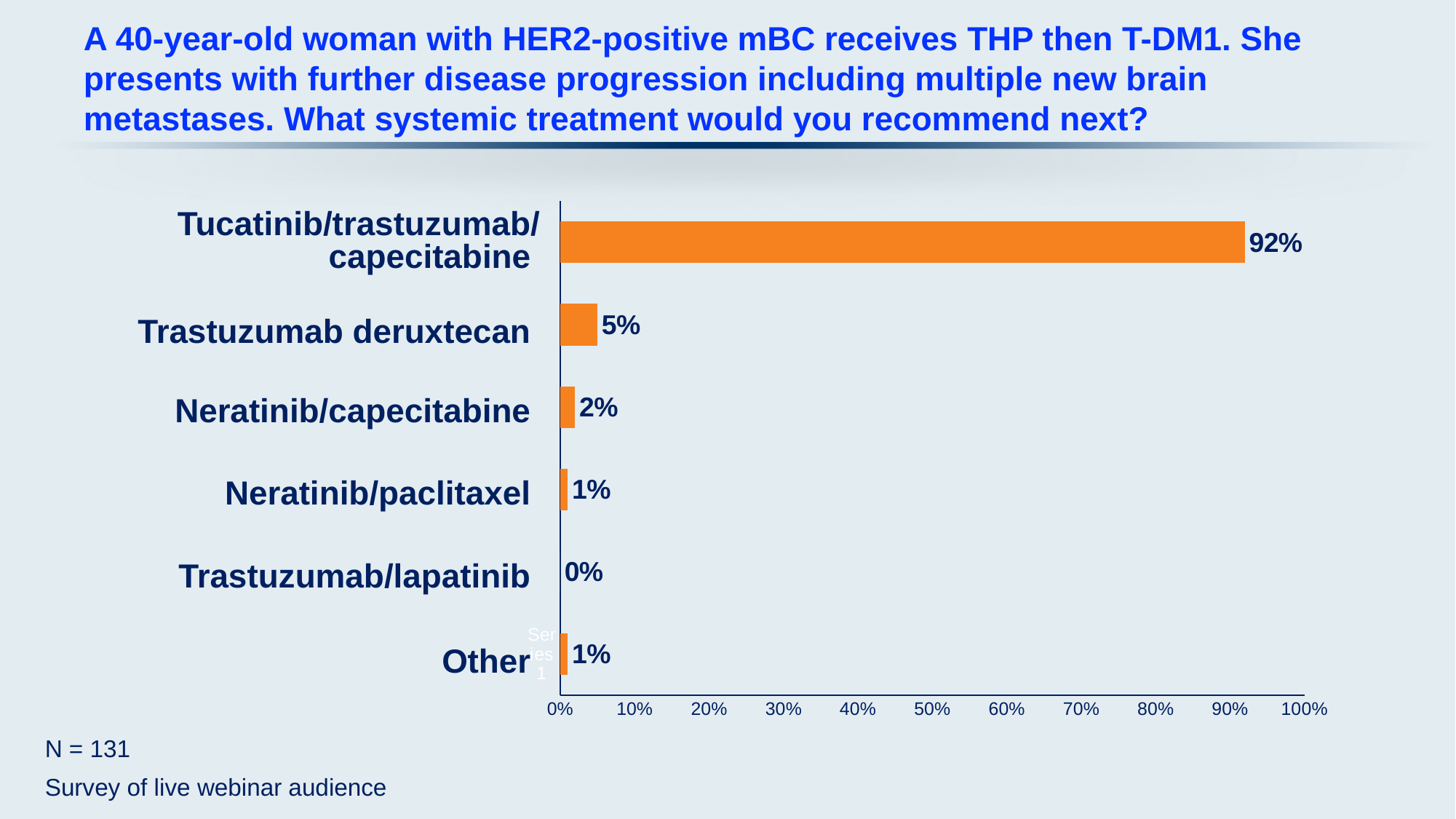
What is the value shown for Trastuzumab/lapatinib? 0% What percentage of respondents chose Tucatinib/trastuzumab/capecitabine? 92% What is the value shown for Neratinib/capecitabine? 2% What is the difference in percentage points between Tucatinib/trastuzumab/capecitabine and Trastuzumab deruxtecan? 87 Which received a larger share of responses, Trastuzumab deruxtecan or Neratinib/capecitabine? Trastuzumab deruxtecan Which treatment option received the highest share of responses? Tucatinib/trastuzumab/capecitabine How many treatment options are listed on the chart? 6 What type of chart is shown on the slide? Bar chart What percentage of respondents chose Trastuzumab deruxtecan? 5% Is the value for Tucatinib/trastuzumab/capecitabine greater or less than 90%? greater Which treatment option received the lowest share of responses? Trastuzumab/lapatinib What is the sample size (N) stated on the slide? N = 131